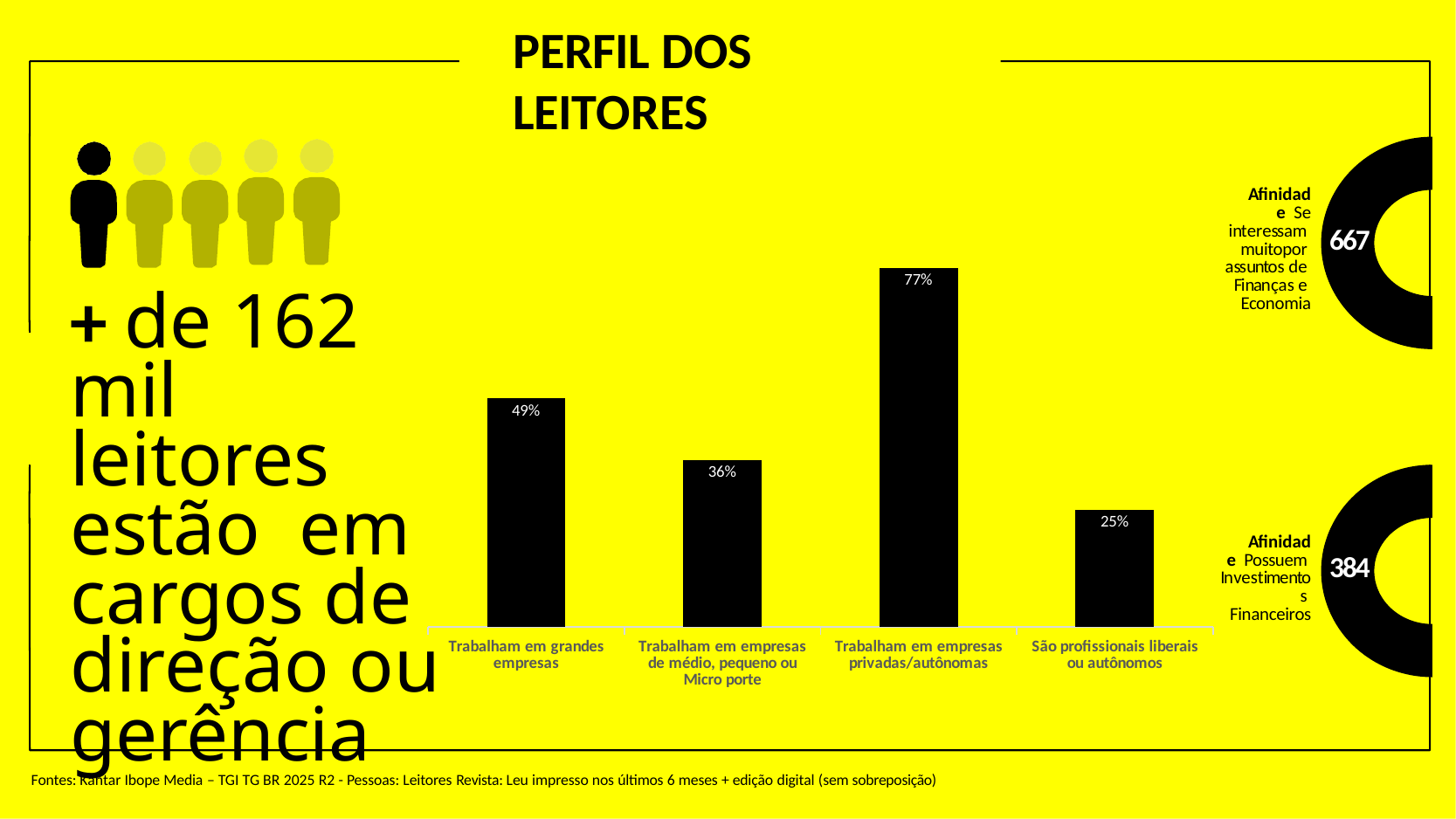
In the bar chart, what is the value for 'Trabalham em empresas de médio, pequeno ou Micro porte'? 36% In the bar chart, which is larger: 'Trabalham em grandes empresas' or 'Trabalham em empresas de médio, pequeno ou Micro porte'? Trabalham em grandes empresas In the bar chart, what is the value for 'Trabalham em grandes empresas'? 49% In the bar chart, what is the value for 'Trabalham em empresas privadas/autônomas'? 77% How many categories does the bar chart show? 4 In the bar chart, which category has the lowest value? São profissionais liberais ou autônomos In the donut chart on the right labelled 'Afinidade Se interessam muito por assuntos de Finanças e Economia', what value is shown? 667 In the bar chart, what is the value for 'São profissionais liberais ou autônomos'? 25% In the bar chart, what is the difference between 'Trabalham em empresas privadas/autônomas' and 'São profissionais liberais ou autônomos'? 52% In the donut chart on the right labelled 'Afinidade Possuem Investimentos Financeiros', what value is shown? 384 What kind of chart is the chart in the centre of the slide? Bar chart In the bar chart, which category has the highest value? Trabalham em empresas privadas/autônomas